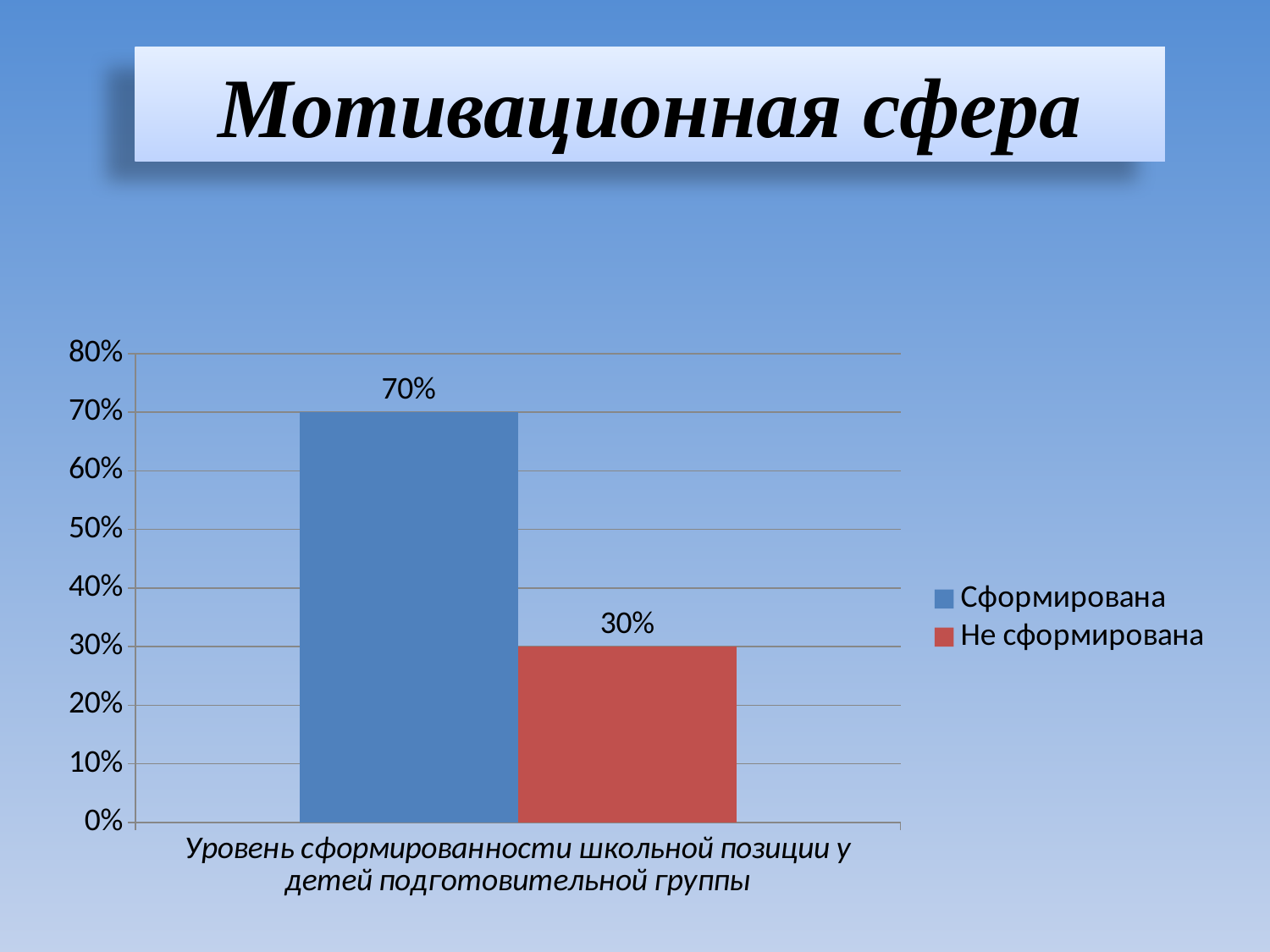
Is the value for Сформирована greater or less than 50%? greater Is the value for Не сформирована greater or less than 40%? less How many series does the legend list? 2 What is the difference between the values for Сформирована and Не сформирована? 40% What is the category label shown under the bars? Уровень сформированности школьной позиции у детей подготовительной группы What colour is the bar for Не сформирована? red Which series has the highest value? Сформирована What kind of chart is shown on the slide? bar chart What is the value for Не сформирована? 30% Which series has the lowest value? Не сформирована Which is larger, the value for Сформирована or for Не сформирована? Сформирована What is the value for Сформирована? 70%